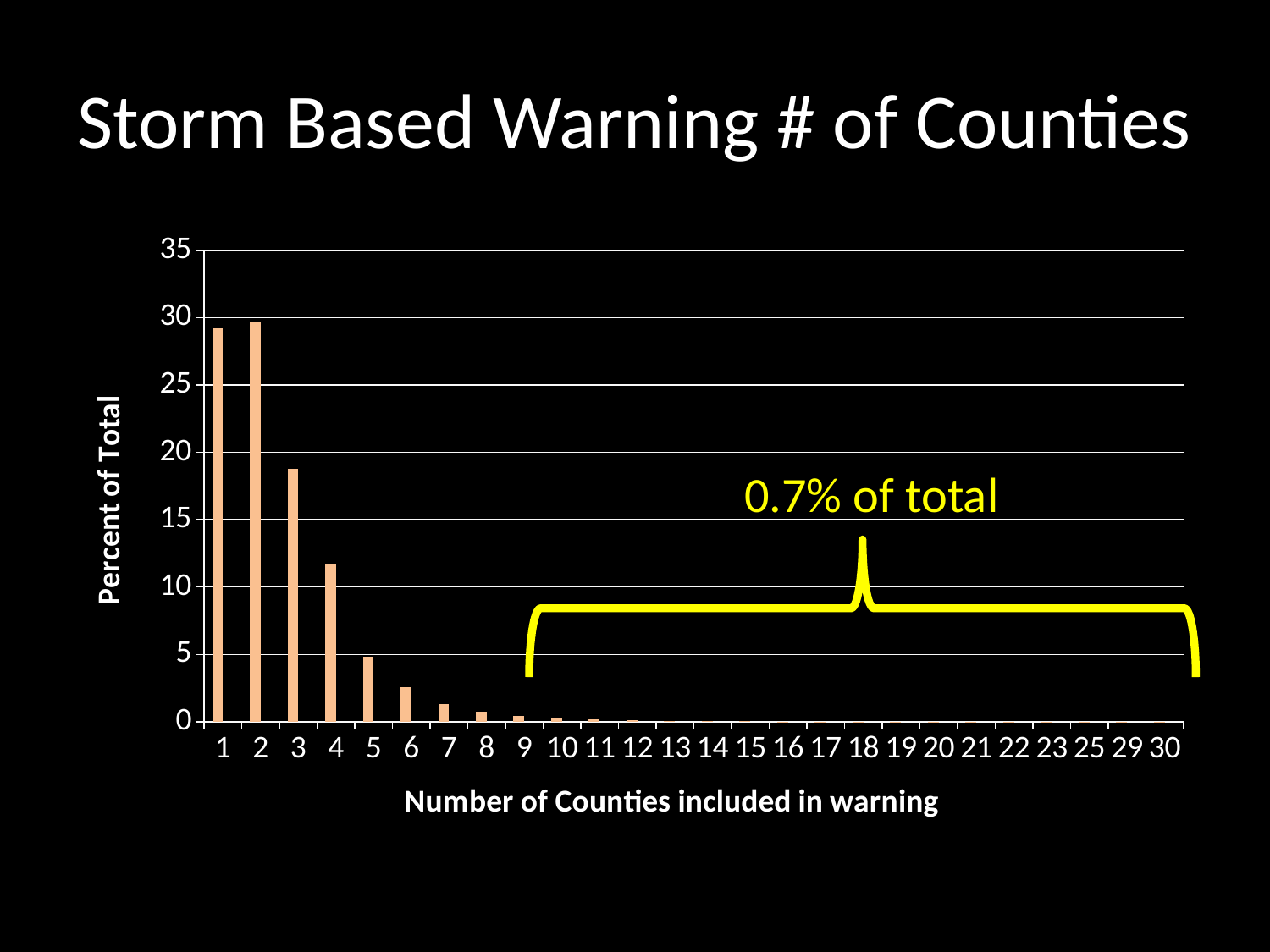
What is the label of the y axis? Percent of Total Is the value for 5 counties greater or less than 10? less Which has a larger value, 1 county or 3 counties? 1 county Is the value for 4 counties greater or less than 10? greater What is the title of the chart? Storm Based Warning # of Counties Is the value for 3 counties greater or less than 15? greater How many categories are shown on the x axis of the chart? 26 What kind of chart is shown on the slide? bar chart Do the values generally rise or fall as the number of counties increases along the x axis? fall Which has a larger value, 3 counties or 4 counties? 3 counties